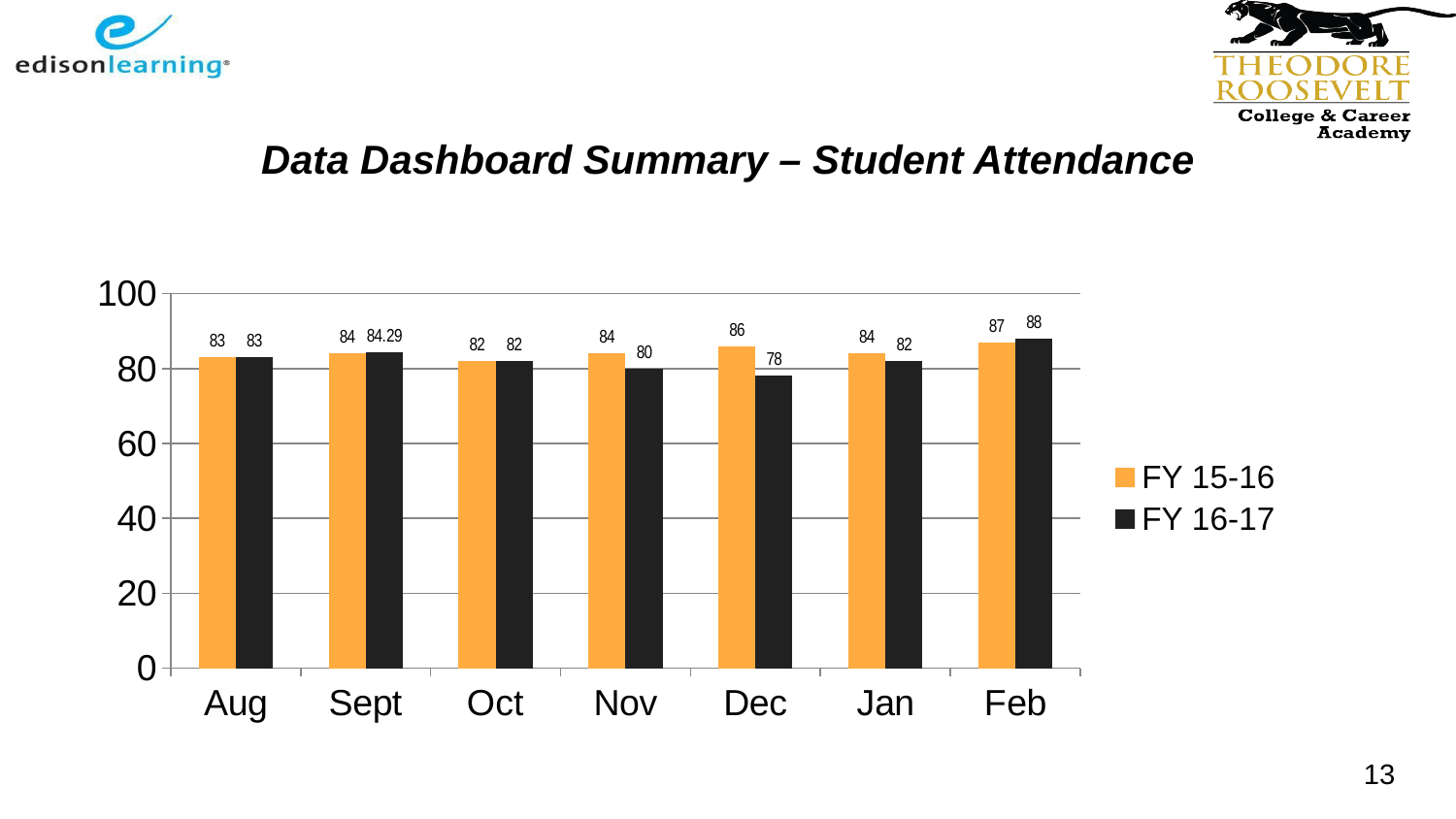
How many months are shown on the x axis? 7 Which month has the lowest FY 16-17 value? Dec What is the FY 16-17 value for Nov? 80 Which colour represents FY 16-17 in the legend? Black How many series does the legend list? 2 Which month has the highest FY 15-16 value? Feb Which month has the highest FY 16-17 value? Feb What kind of chart is shown on the slide? Bar chart What is the difference between the FY 15-16 and FY 16-17 values for Dec? 8 What is the FY 16-17 value for Sept? 84.29 Which is larger for Jan, the FY 15-16 value or the FY 16-17 value? FY 15-16 What is the FY 15-16 value for Dec? 86